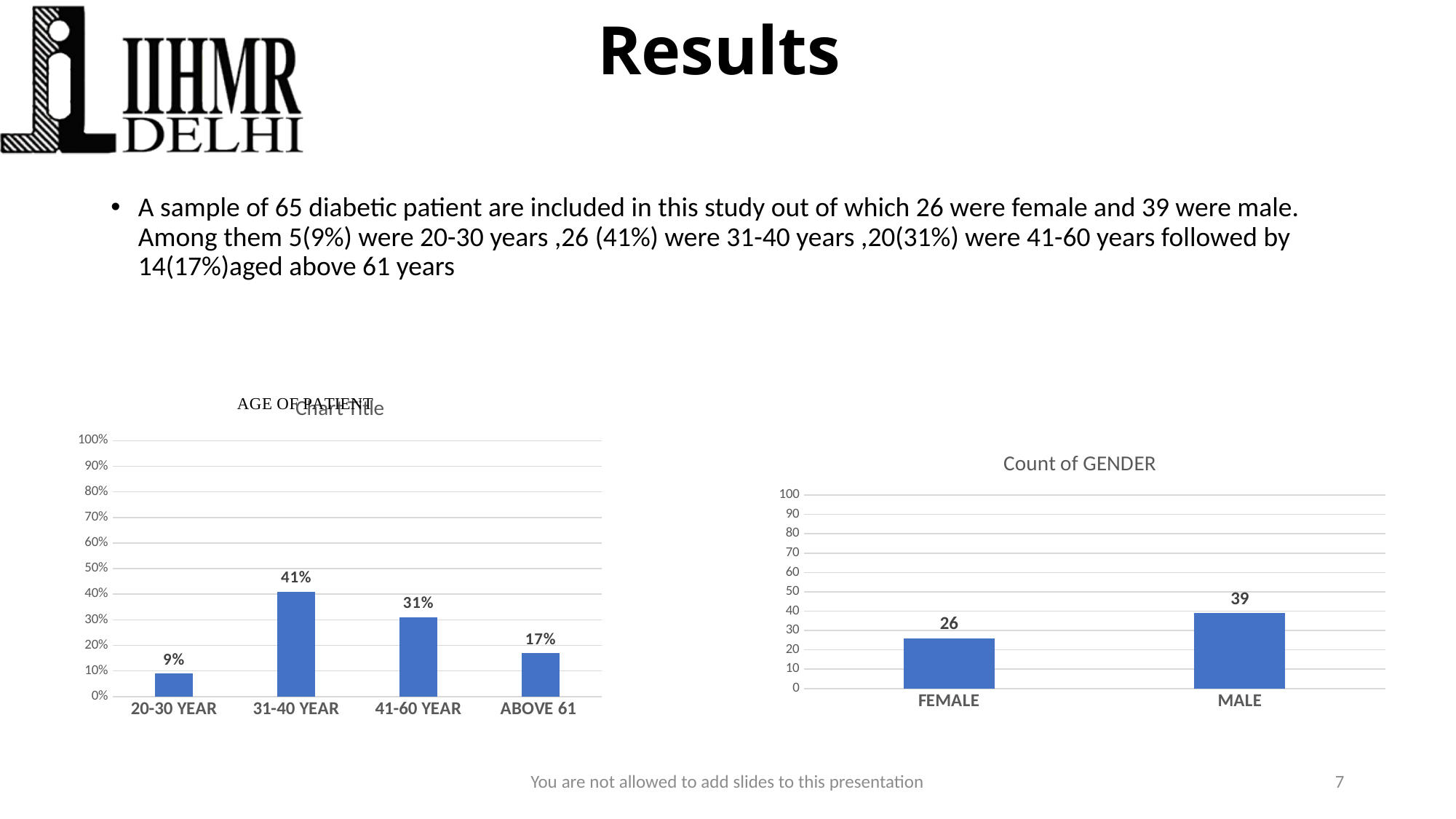
In the AGE OF PATIENT chart on the left, what is the value for ABOVE 61? 17% What type of chart is the Count of GENDER chart on the right? Bar chart In the Count of GENDER chart on the right, what is the value for FEMALE? 26 In the AGE OF PATIENT chart on the left, which age group has the highest value? 31-40 YEAR In the AGE OF PATIENT chart on the left, what is the difference between the values for 31-40 YEAR and 41-60 YEAR? 10% In the Count of GENDER chart on the right, which category is larger, FEMALE or MALE? MALE In the AGE OF PATIENT chart on the left, which age group has the lowest value? 20-30 YEAR In the Count of GENDER chart on the right, what is the value for MALE? 39 In the AGE OF PATIENT chart on the left, what is the value for 31-40 YEAR? 41% In the AGE OF PATIENT chart on the left, how many age categories are shown? 4 In the Count of GENDER chart on the right, what is the difference between the MALE and FEMALE counts? 13 In the AGE OF PATIENT chart on the left, is the value for 41-60 YEAR greater or less than 50%? less